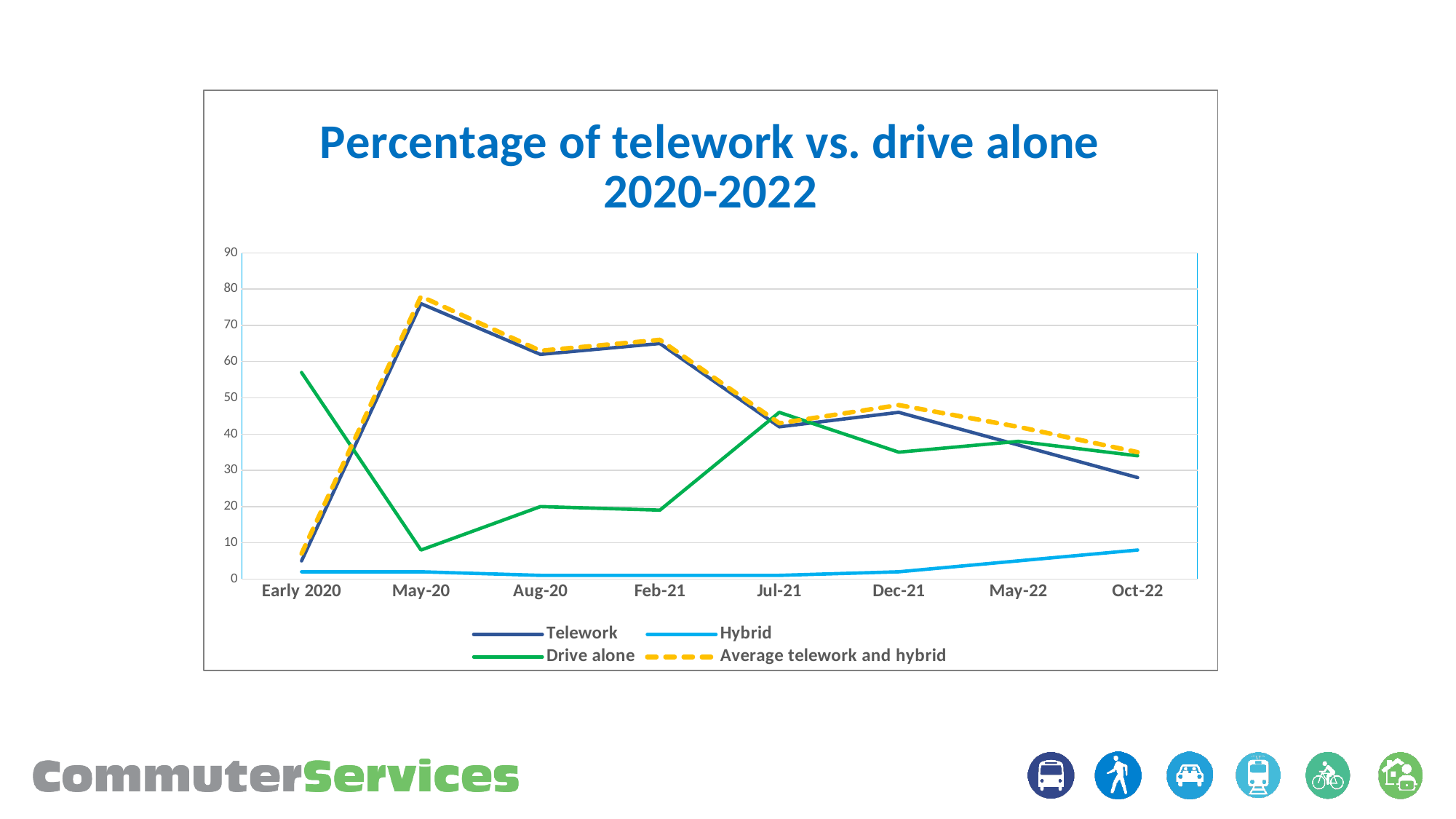
How many series does the legend list? 4 At which time point is the Drive alone series at its lowest? May-20 Does the Telework series rise or fall overall from May-20 to Oct-22? fall Is the Hybrid value for Oct-22 greater or less than 10? less In Dec-21, which is larger: Telework or Drive alone? Telework At which time point does the Telework series reach its highest value? May-20 How many time points are plotted along the x axis? 8 In Early 2020, which is larger: Telework or Drive alone? Drive alone What kind of chart is shown on the slide? line chart Is the Telework value for May-20 greater or less than 70? greater Is the Drive alone value for Aug-20 greater or less than 30? less At which time point is the Drive alone series at its highest? Early 2020